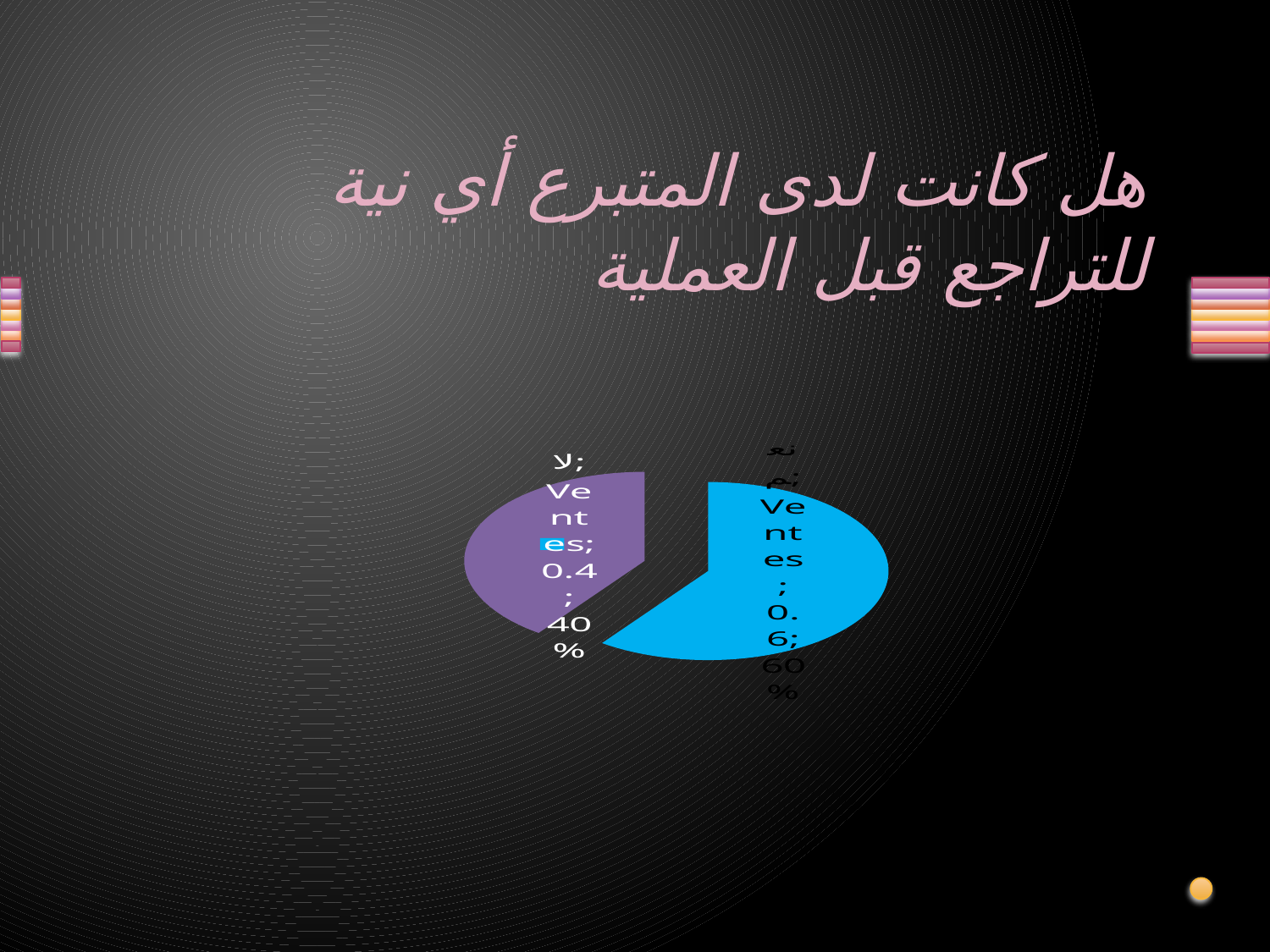
What kind of chart is shown on the slide? pie chart How many slices does the pie chart have? 2 What colour is the "نعم" slice? blue Which slice is the smallest in the pie chart? لا Which is larger, the "نعم" slice or the "لا" slice? نعم What percentage share does the "نعم" slice have? 60% What value is printed for the "نعم" slice? 0.6 What is the difference in percentage points between the "نعم" and "لا" slices? 20% What value is printed for the "لا" slice? 0.4 What percentage share does the "لا" slice have? 40% Which slice is the largest in the pie chart? نعم What series name is printed in the data labels of the pie chart? Ventes